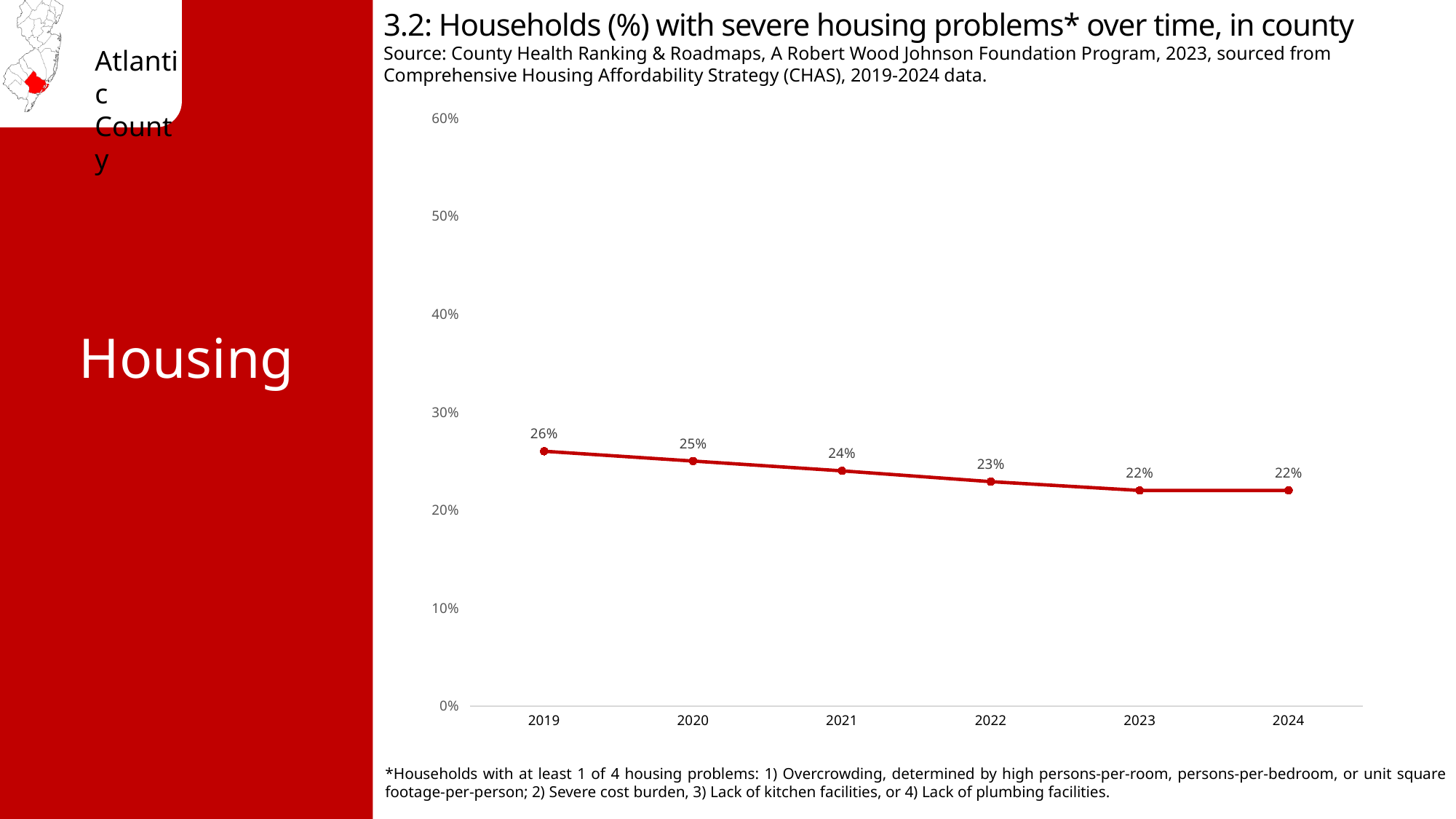
How many years are plotted on the chart? 6 Do the values rise or fall from 2019 to 2024? fall Which year has the larger value, 2020 or 2023? 2020 What is the difference between the values for 2020 and 2022? 2% What is the value shown for 2021? 24% What is the title of the chart? 3.2: Households (%) with severe housing problems* over time, in county What is the difference between the 2019 value and the 2024 value? 4% What kind of chart is shown on the slide? line chart What percentage of households had severe housing problems in 2019? 26% Which year has the highest percentage of households with severe housing problems? 2019 Is the value for 2022 greater or less than 30%? less What percentage of households had severe housing problems in 2024? 22%